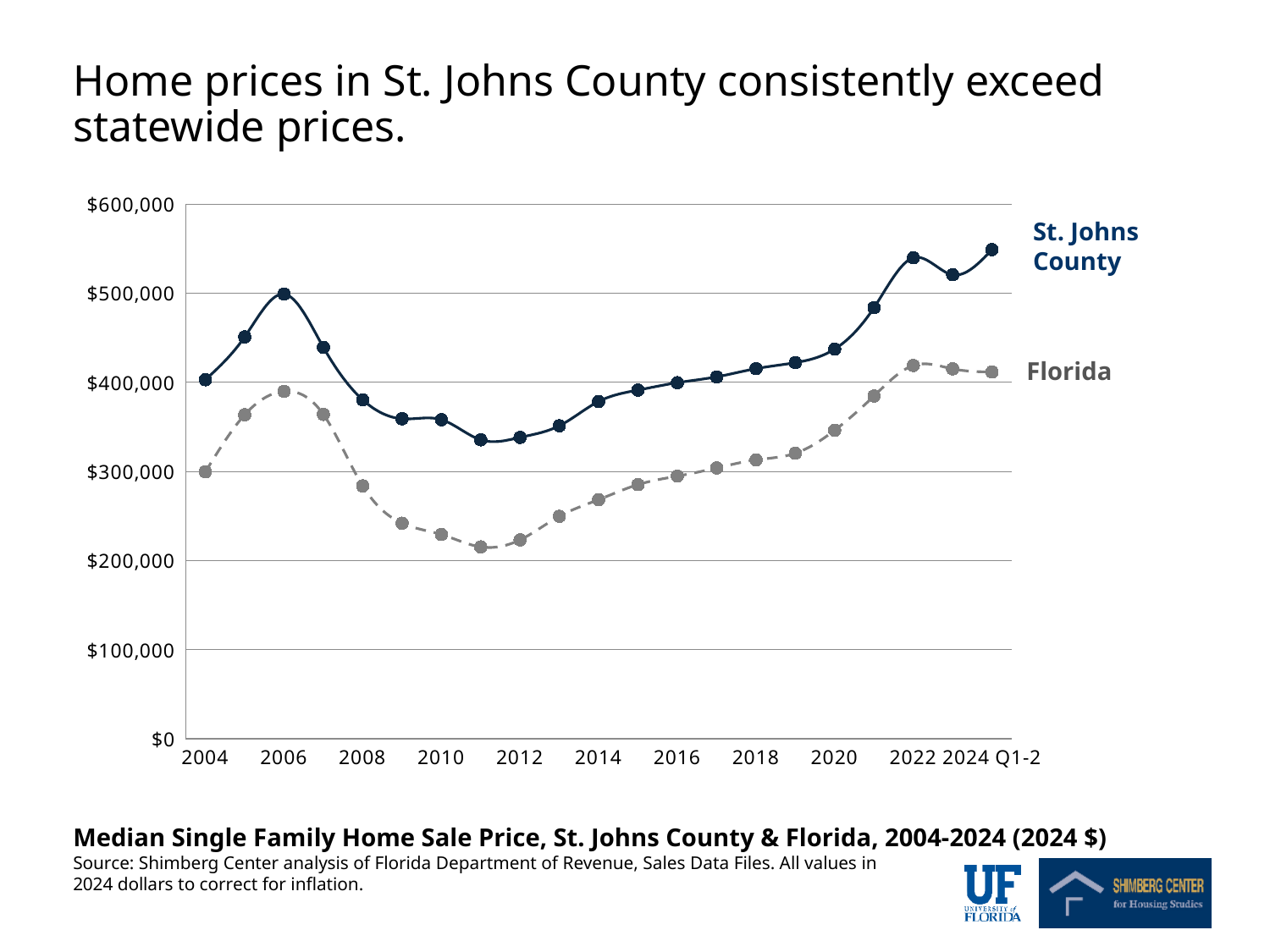
Does the St. Johns County line rise or fall between 2006 and 2011? fall How many data points are plotted for the St. Johns County series? 21 Is the St. Johns County value for 2011 greater or less than $300,000? greater How many series are plotted on the chart? 2 Does the Florida line rise or fall between 2011 and 2022? rise Is the Florida value for 2011 greater or less than $300,000? less Which two series are plotted on the chart? St. Johns County and Florida Is the Florida value for 2008 greater or less than $300,000? less What is the title of the chart? Median Single Family Home Sale Price, St. Johns County & Florida, 2004-2024 (2024 $) In 2006, which series has the higher value, St. Johns County or Florida? St. Johns County What kind of chart is shown on the slide? line chart